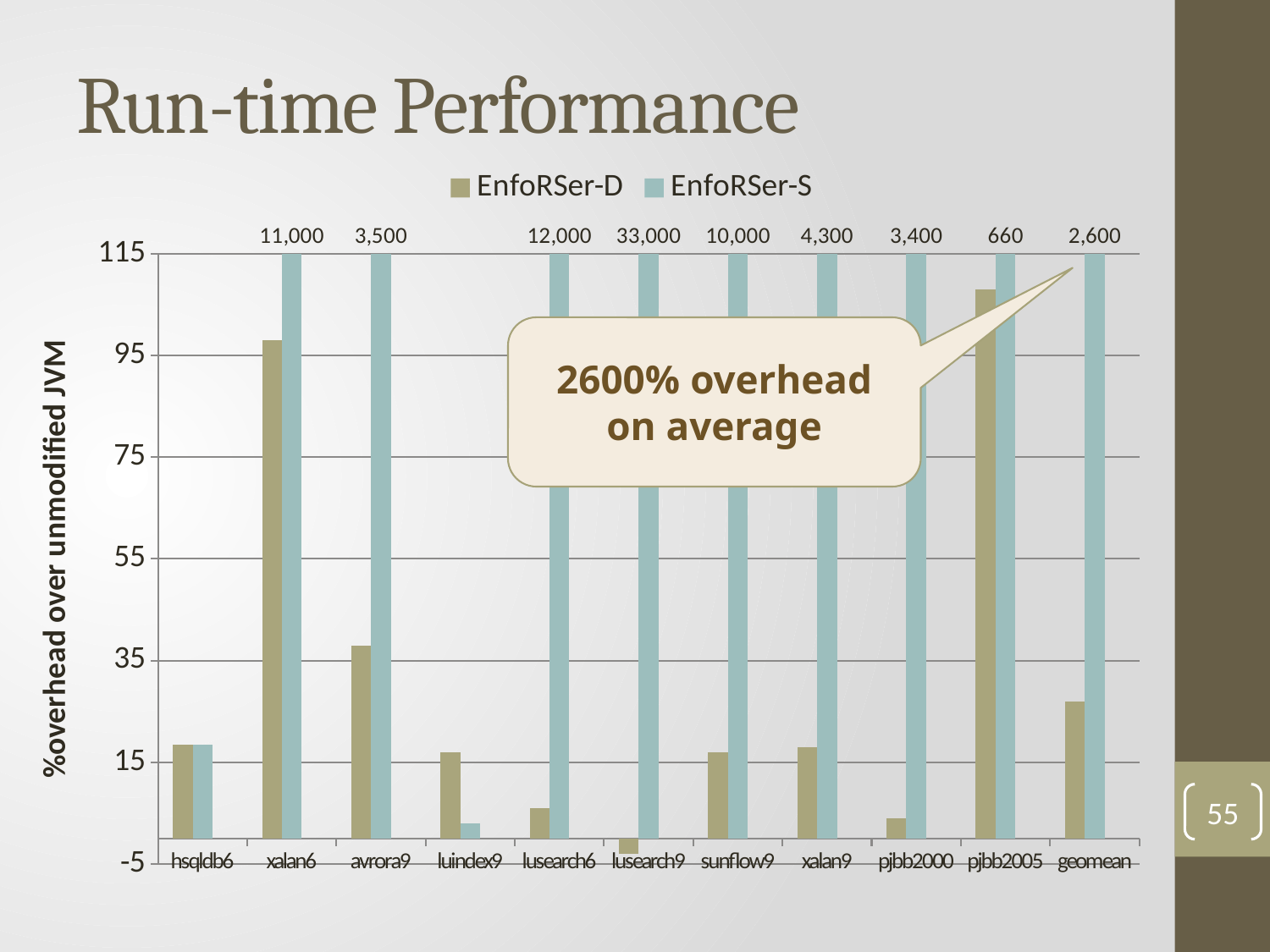
How many series does the legend list? 2 How many categories are shown on the x axis? 11 Is the EnfoRSer-D value for xalan6 greater or less than 75? greater Which category has the highest EnfoRSer-D value? pjbb2005 What is the EnfoRSer-S value for pjbb2005? 660 What is the label on the y axis? %overhead over unmodified JVM Which category has the highest EnfoRSer-S value? lusearch9 What is the EnfoRSer-S value for geomean? 2,600 What is the EnfoRSer-S value for lusearch9? 33,000 What kind of chart is shown on the slide? bar chart What is the difference between the EnfoRSer-S values for lusearch9 and lusearch6? 21,000 Is the EnfoRSer-D value for avrora9 greater or less than 55? less